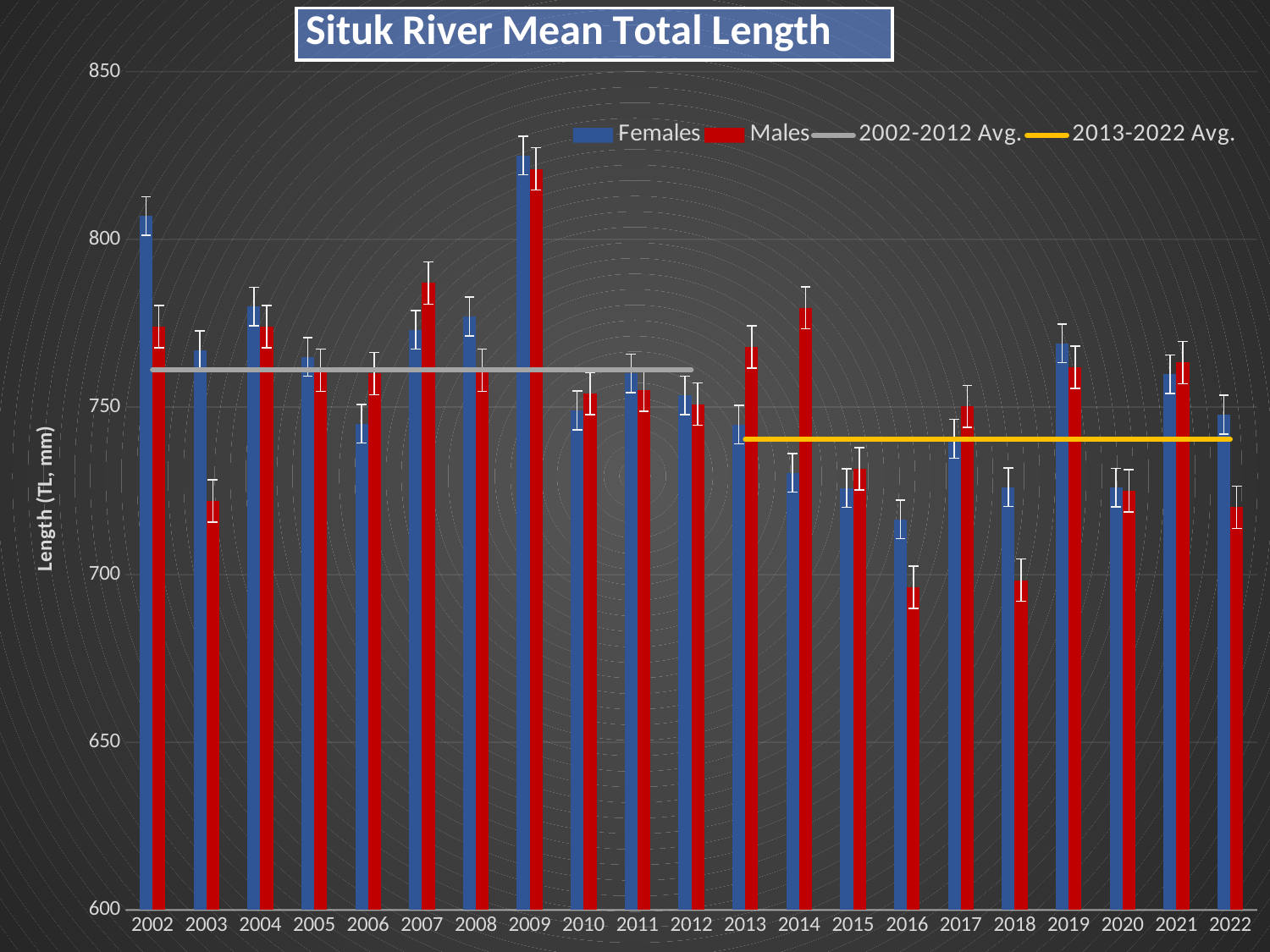
In which year is the Females bar the highest? 2009 Is the Males value for 2014 greater or less than 750? greater In 2003, which is larger, the Females bar or the Males bar? Females Is the Males value for 2003 greater or less than 750? less In 2014, which is larger, the Females bar or the Males bar? Males Is the Females value for 2016 greater or less than 750? less How many years are shown along the x axis of the chart? 21 What kind of chart is shown on the slide? Bar chart How many entries does the chart's legend list? 4 What is the label on the chart's y axis? Length (TL, mm) In which year is the Males bar the lowest? 2016